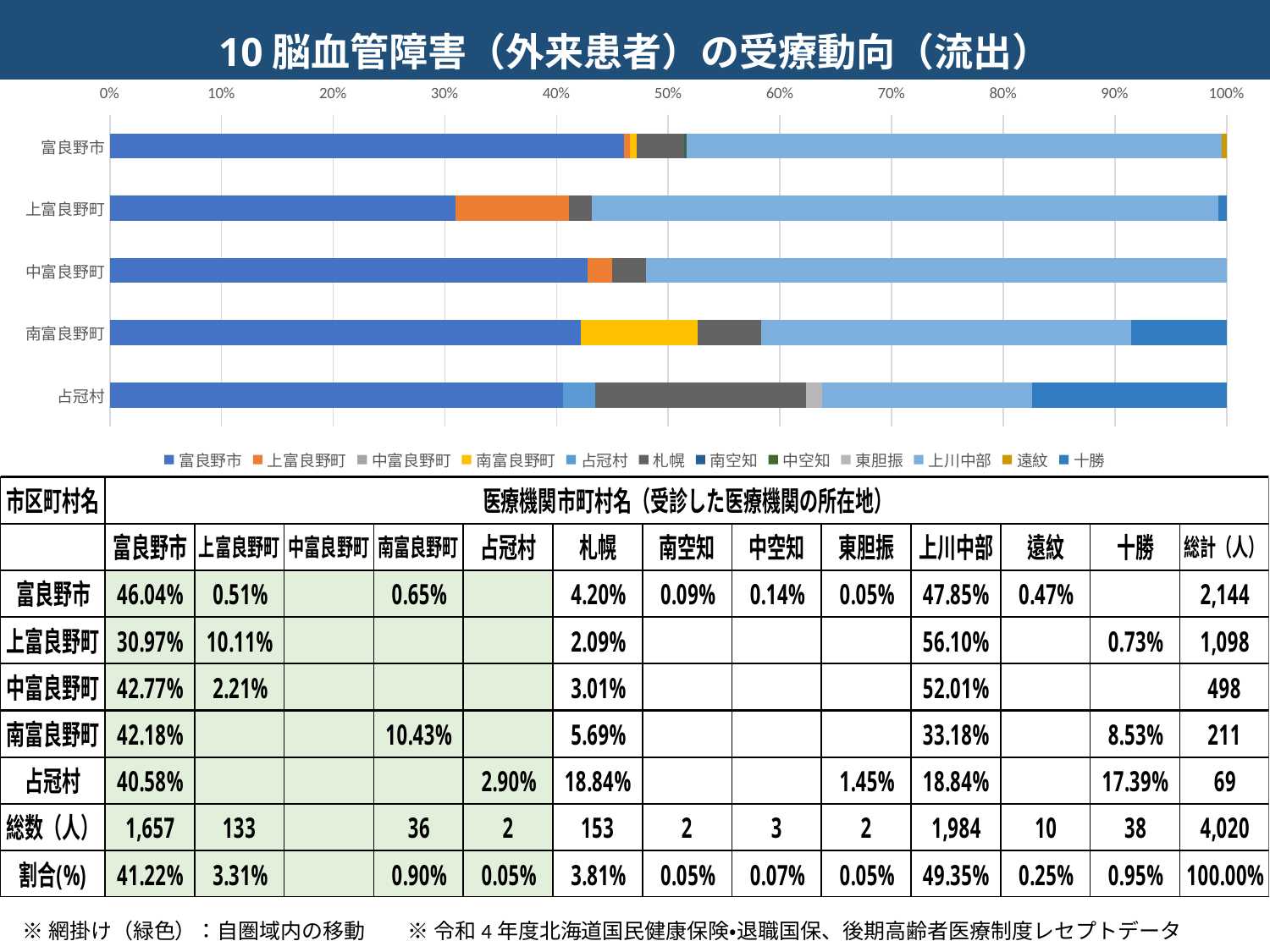
Is the 富良野市 segment of the 富良野市 bar greater or less than 40%? greater What is the difference between the 上川中部 share for 上富良野町 and for 富良野市? 8.25 percentage points What share of 占冠村 patients went to 十勝? 17.39% What share of 富良野市 patients went to 上川中部? 47.85% How many municipalities (categories) are plotted on the y axis of the chart? 5 What kind of chart is shown on the slide? Stacked bar chart What share of 南富良野町 patients went to 十勝? 8.53% Which has the larger 札幌 share, 南富良野町 or 占冠村? 占冠村 Which municipality has the smallest 上川中部 segment in its bar? 占冠村 What is the title of the slide's chart? 10 脳血管障害（外来患者）の受療動向（流出） How many series does the chart legend list? 12 Which municipality has the largest 上川中部 segment in its bar? 上富良野町